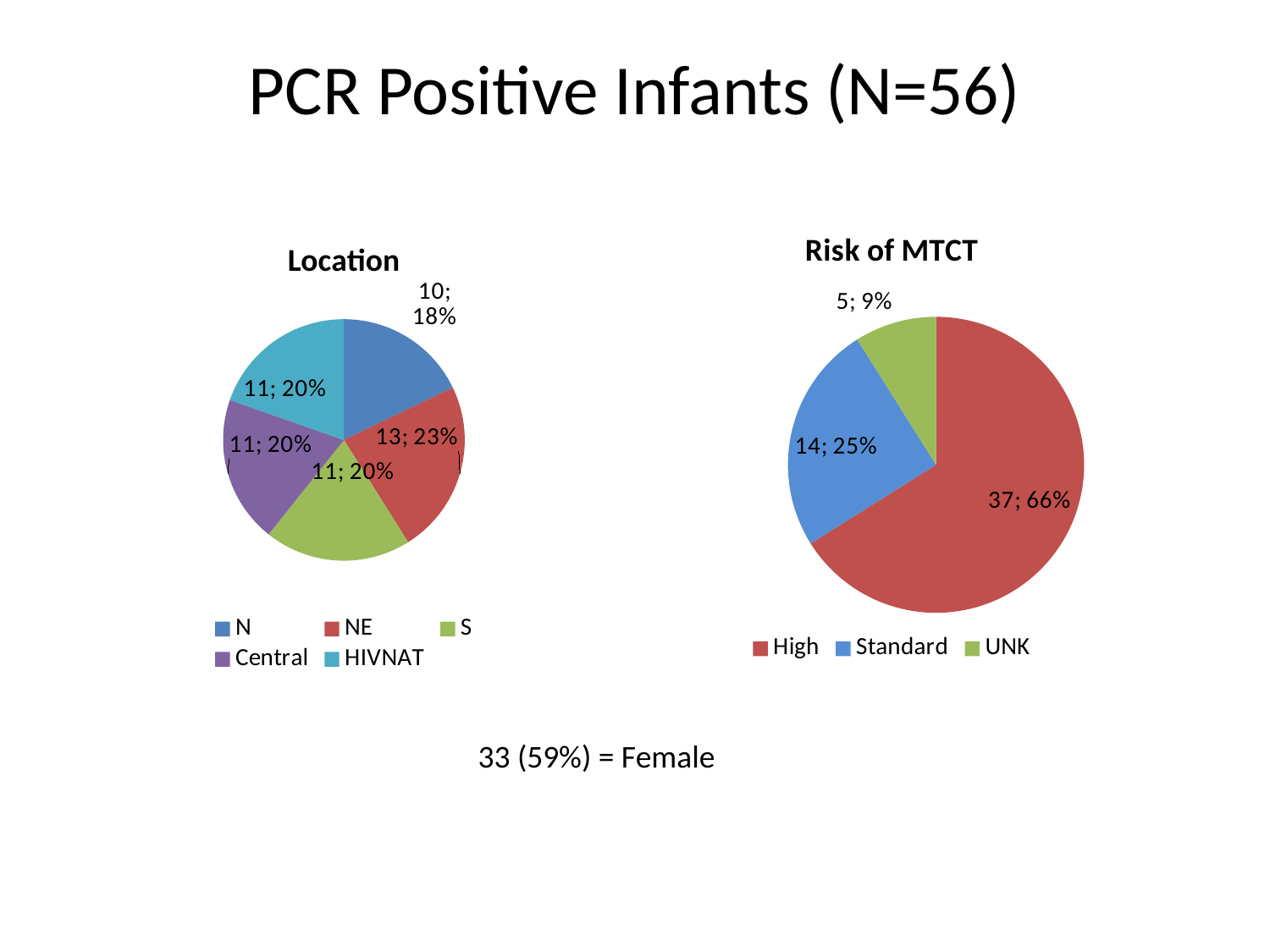
In the "Risk of MTCT" chart, how many infants are in the High category? 37 In the "Location" chart, what is the difference between the NE count and the N count? 3 In the "Risk of MTCT" chart, which category has the smallest slice? UNK In the "Location" chart, how many infants are in the NE category? 13 How many categories does the "Location" chart show? 5 In the "Location" chart, which category has the smallest slice? N In the "Risk of MTCT" chart, what share of the pie does Standard represent? 25% In the "Location" chart, what share of the pie does N represent? 18% In the "Risk of MTCT" chart, which colour represents the High category? red In the "Risk of MTCT" chart, what is the difference between the High count and the Standard count? 23 What type of chart is the "Location" chart? pie chart In the "Location" chart, which category has the largest slice? NE